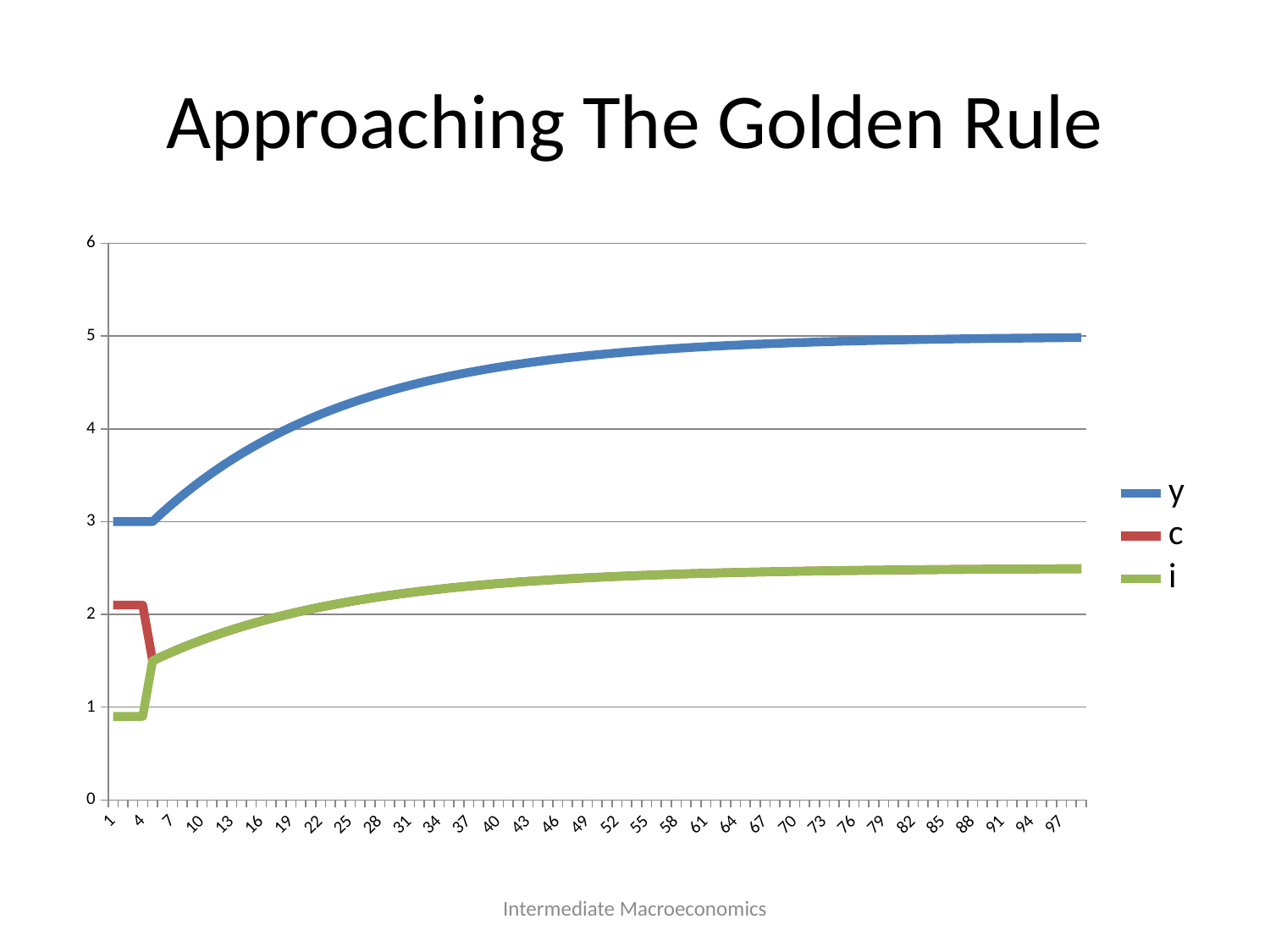
Which series has the highest value at x = 97? y What are the series names listed in the legend? y, c, i What is the value of the y series at x = 1? 3 Does the y series rise or fall as x increases? rises Which series has the lowest value at x = 1? i Is the value of the i series at x = 97 greater or less than 2? greater Is the value of the y series at x = 97 greater or less than 4? greater Is the value of the c series at x = 1 greater or less than 3? less What is the title of the slide containing the chart? Approaching The Golden Rule How many series does the legend list? 3 What kind of chart is shown on the slide? line chart